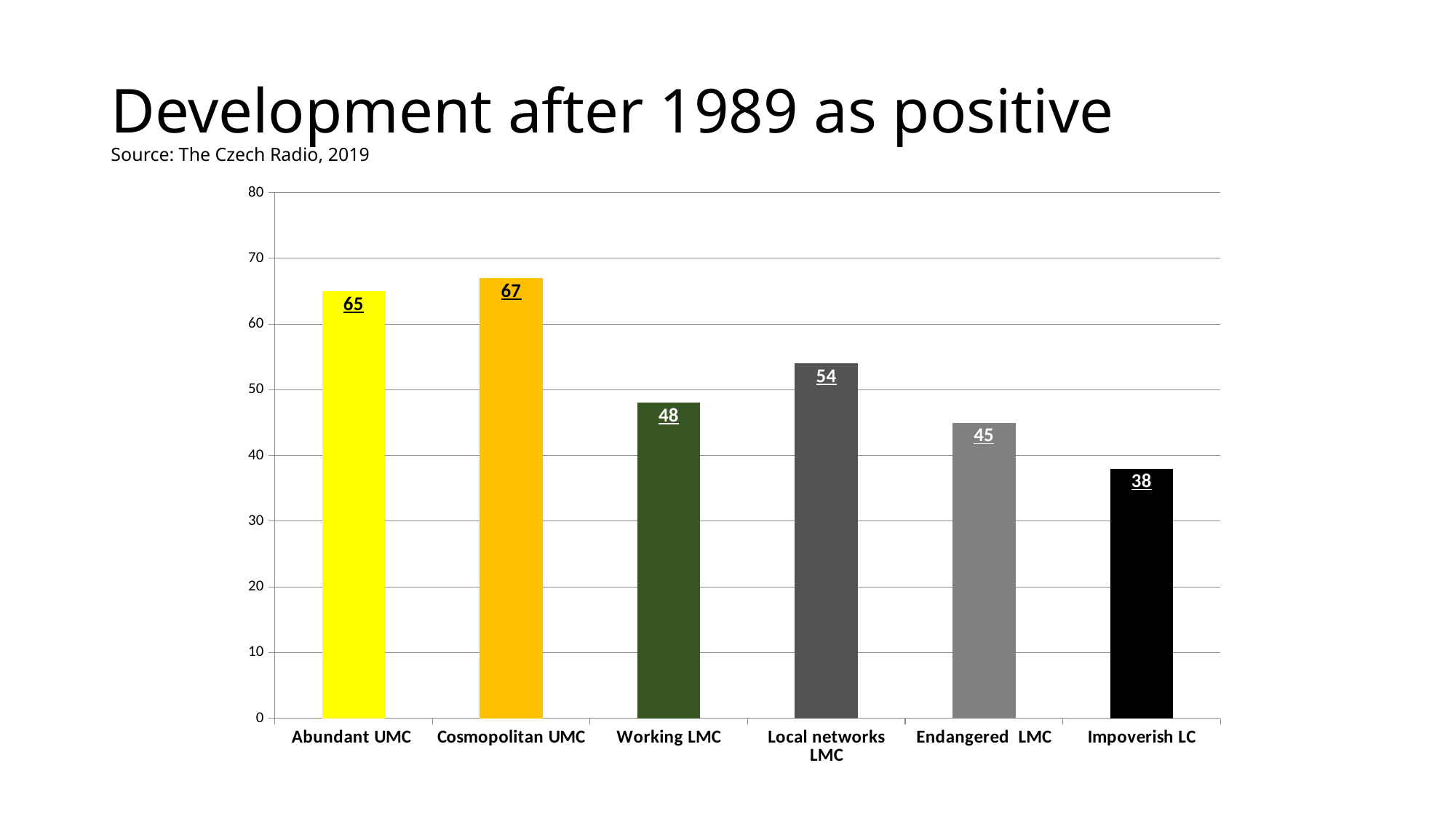
What is the value for Impoverish LC? 38 Which category has the highest value? Cosmopolitan UMC What is the difference between the values for Local networks LMC and Endangered LMC? 9 How many categories are shown in the chart? 6 What is the source cited for the chart? The Czech Radio, 2019 Which category has the lowest value? Impoverish LC What is the value for Local networks LMC? 54 Is the value for Abundant UMC greater or less than 60? greater Which is larger, the value for Working LMC or the value for Endangered LMC? Working LMC What kind of chart is shown on the slide? Bar chart What is the difference between the values for Abundant UMC and Working LMC? 17 What is the value for Cosmopolitan UMC? 67